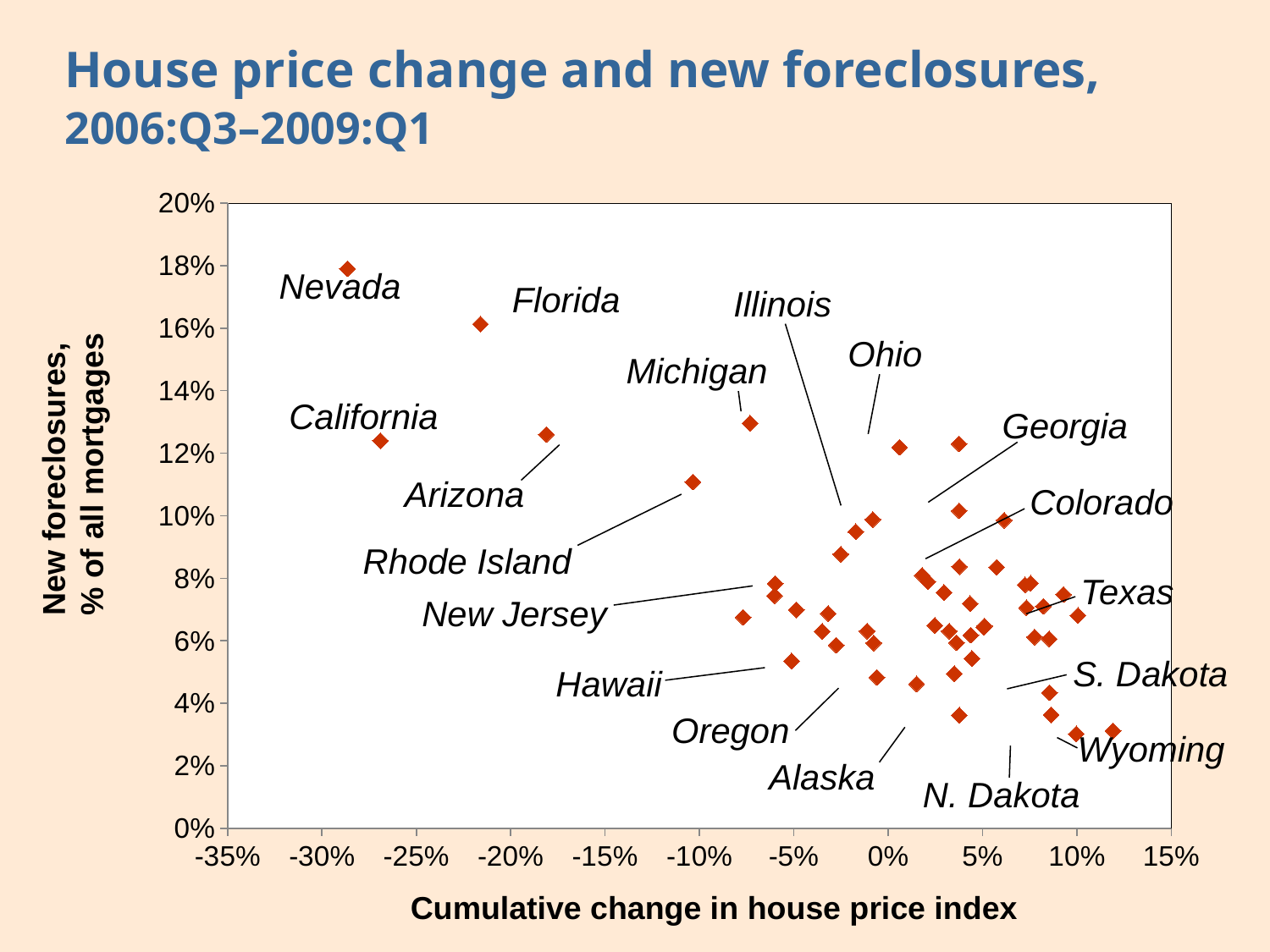
What is the label of the x axis? Cumulative change in house price index Which has a higher new foreclosure rate, Nevada or Florida? Nevada Which labeled state has the highest rate of new foreclosures? Nevada Is the new foreclosure rate for Hawaii greater or less than 6%? less Is the new foreclosure rate for Florida greater or less than 14%? greater Is the new foreclosure rate for Nevada greater or less than 16%? greater Which has a higher new foreclosure rate, Michigan or Rhode Island? Michigan As the cumulative change in house price index increases along the x axis, do new foreclosures generally rise or fall? fall What kind of chart is shown on the slide? scatter chart